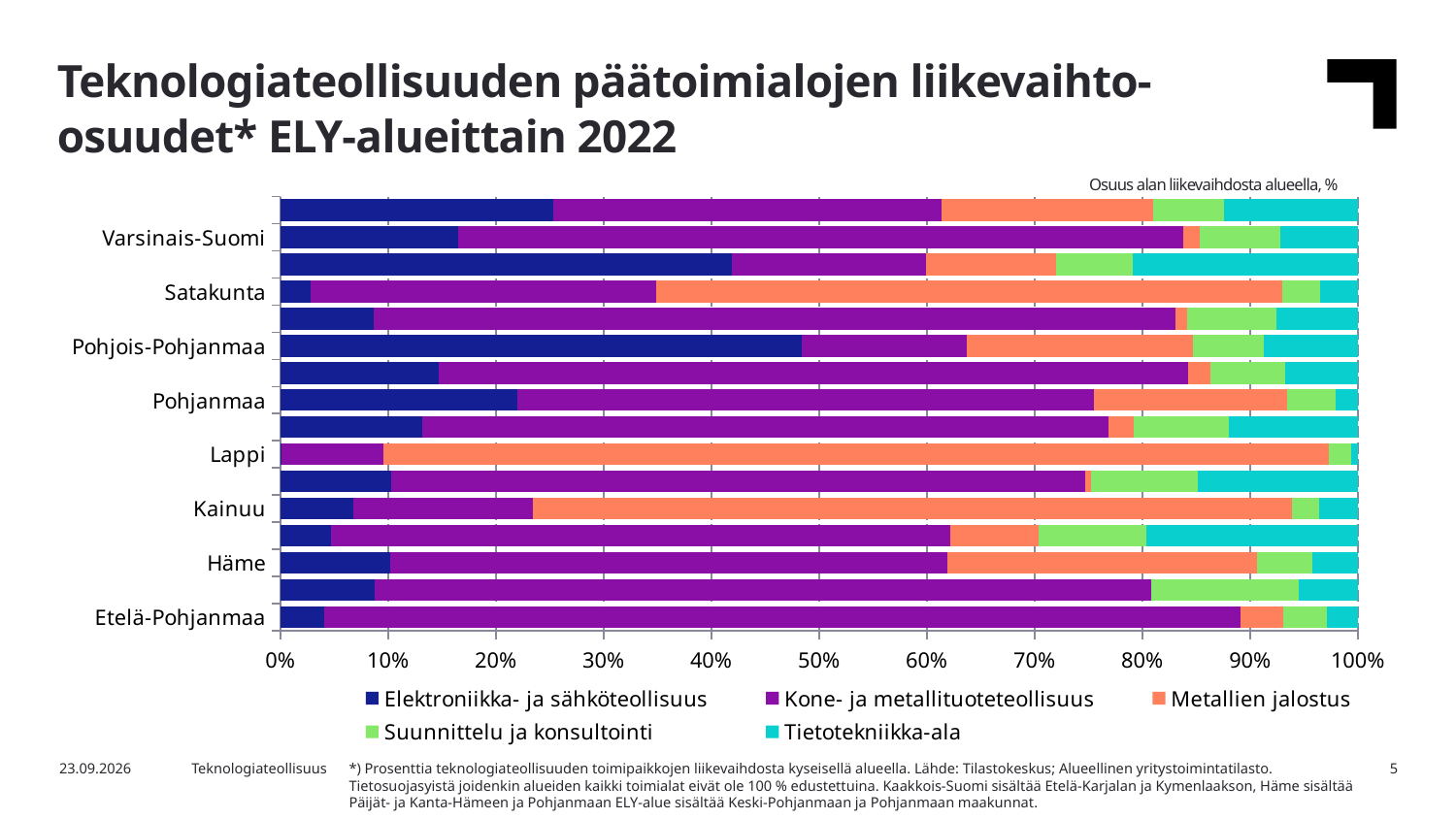
Is the share of Elektroniikka- ja sähköteollisuus for Pohjois-Pohjanmaa greater or less than 40%? greater How many region labels are shown on the vertical axis of the chart? 8 What is the highest value shown on the horizontal axis? 100% Is the share of Metallien jalostus for Lappi greater or less than 80%? greater Is the share of Metallien jalostus for Satakunta greater or less than 50%? greater Which has the larger share of Elektroniikka- ja sähköteollisuus, Pohjois-Pohjanmaa or Satakunta? Pohjois-Pohjanmaa Which series is shown in orange in the legend? Metallien jalostus Which series has the largest share in the Lappi bar? Metallien jalostus What kind of chart is shown on the slide? Stacked bar chart How many series does the legend list? 5